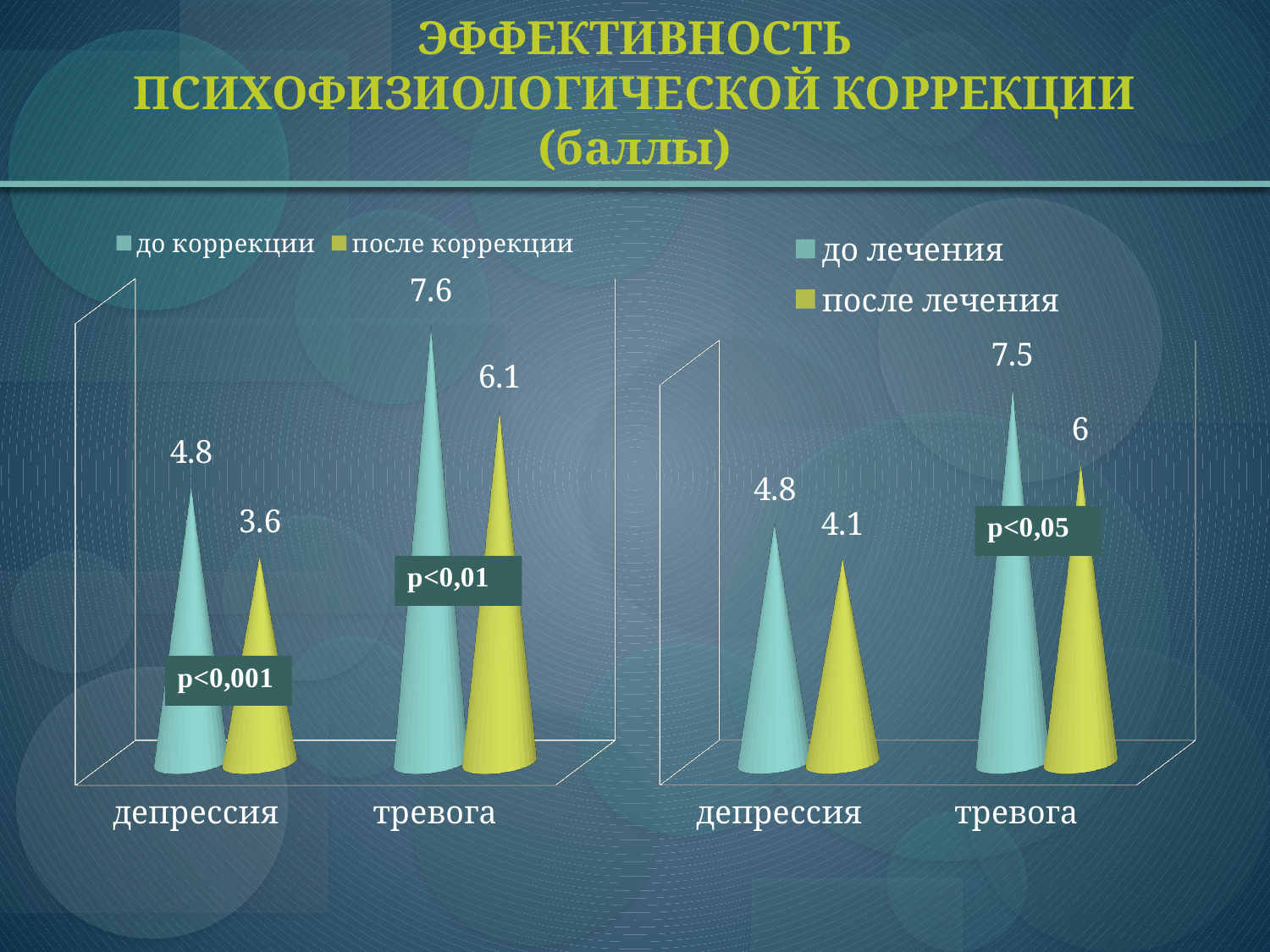
In the left chart, what is the value for депрессия in the до коррекции series? 4.8 In the left chart, which is larger for депрессия: the до коррекции value or the после коррекции value? до коррекции What kind of chart is the right chart? bar chart How many categories are shown on the x axis of the left chart? 2 In the right chart, what is the difference between the до лечения and после лечения values for депрессия? 0.7 In the left chart, which category has the highest value in the до коррекции series? тревога In the left chart, what is the difference between the до коррекции and после коррекции values for тревога? 1.5 In the right chart, what is the value for тревога in the до лечения series? 7.5 In the right chart, what is the value for депрессия in the после лечения series? 4.1 In the left chart, what is the value for тревога in the после коррекции series? 6.1 In the right chart, which category has the lowest value in the после лечения series? депрессия How many series does the legend of the right chart list? 2